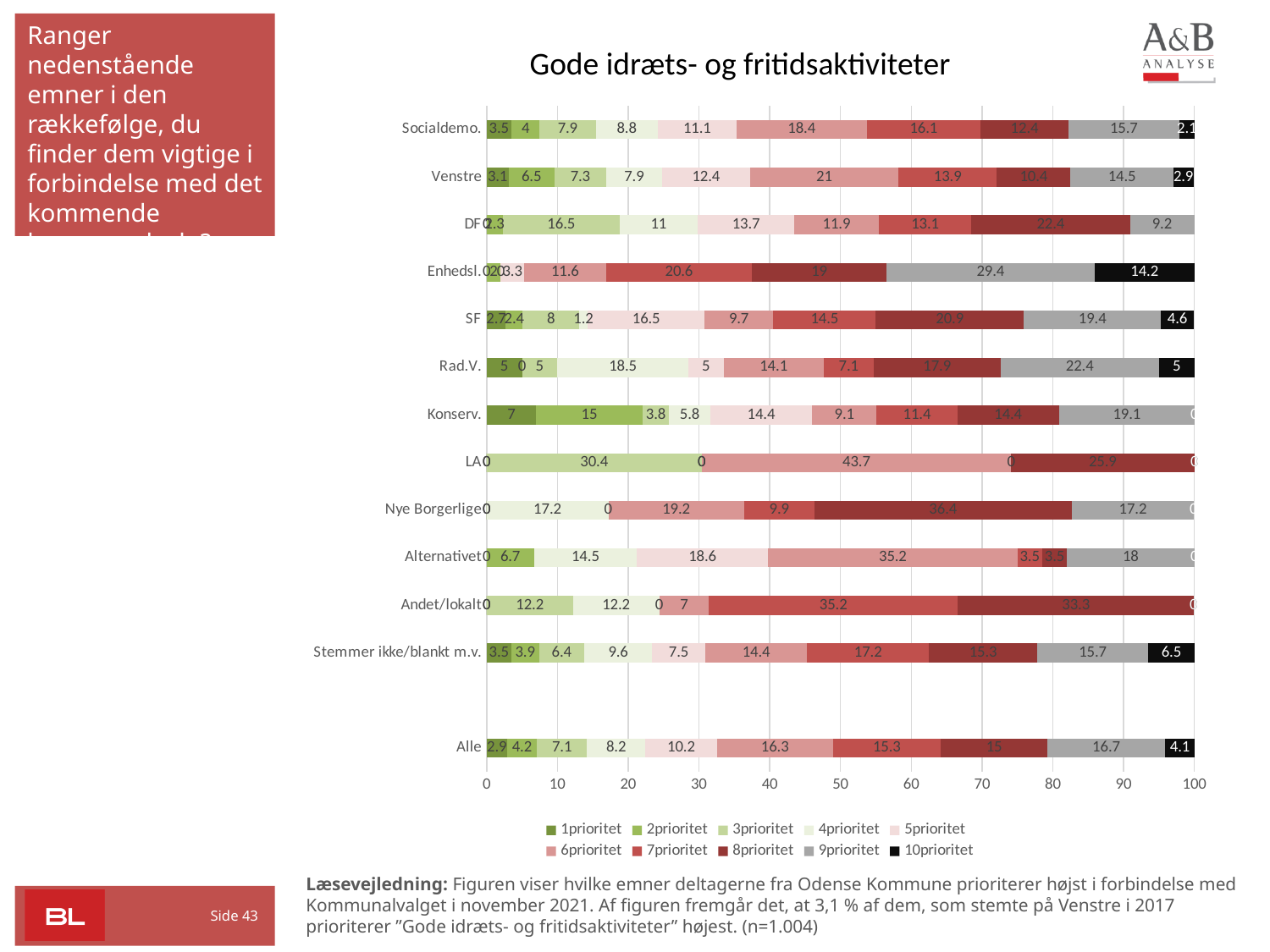
How many categories (voter groups) are shown on the y axis? 13 What is the difference between the 9prioritet value (16.7) and the 10prioritet value (4.1) for Alle? 12.6 What is the title of the chart? Gode idræts- og fritidsaktiviteter What is the 1prioritet value for Konserv.? 7 What is the 9prioritet value for Enhedsl.? 29.4 What is the 10prioritet value for Alle? 4.1 What is the 6prioritet value for LA? 43.7 What is the 6prioritet value for Venstre? 21 Which category has the highest 10prioritet value? Enhedsl. What type of chart is shown on the slide? Stacked bar chart Which has the larger 6prioritet value, Venstre or Socialdemo.? Venstre How many series does the legend list? 10